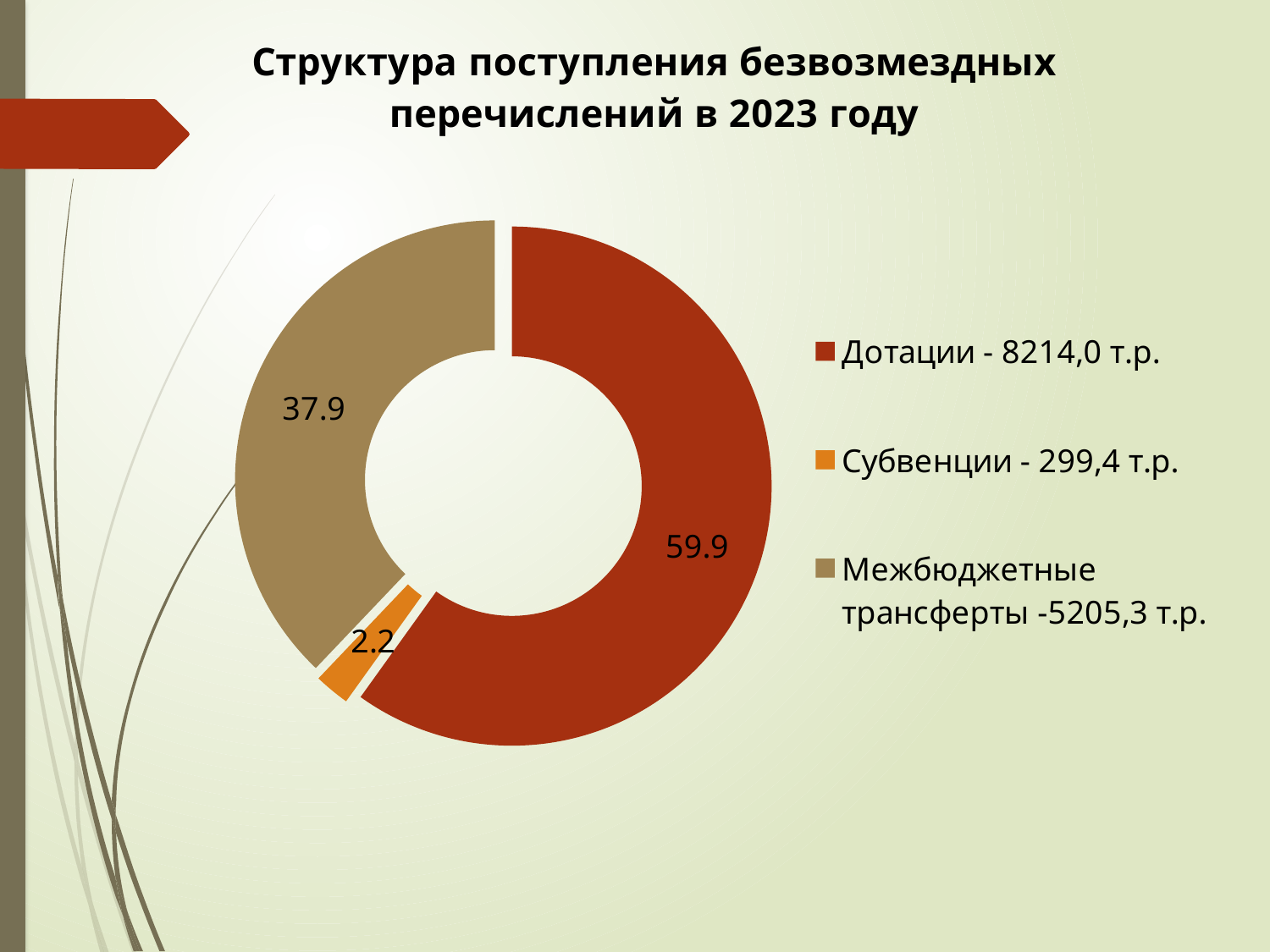
What is the data label shown for the Субвенции slice? 2.2 What is the difference between the data labels for Межбюджетные трансферты and Субвенции? 35.7 What is the data label shown for the Межбюджетные трансферты slice? 37.9 Which category has the smallest slice? Субвенции How many categories does the chart show? 3 Which category has the largest slice? Дотации What is the data label shown for the Дотации slice? 59.9 What is the title of the chart? Структура поступления безвозмездных перечислений в 2023 году What amount is given in the legend for Дотации? 8214,0 т.р. What is the difference between the data labels for Дотации and Межбюджетные трансферты? 22 What kind of chart is shown on the slide? Doughnut (pie) chart Which slice is larger: Межбюджетные трансферты or Субвенции? Межбюджетные трансферты